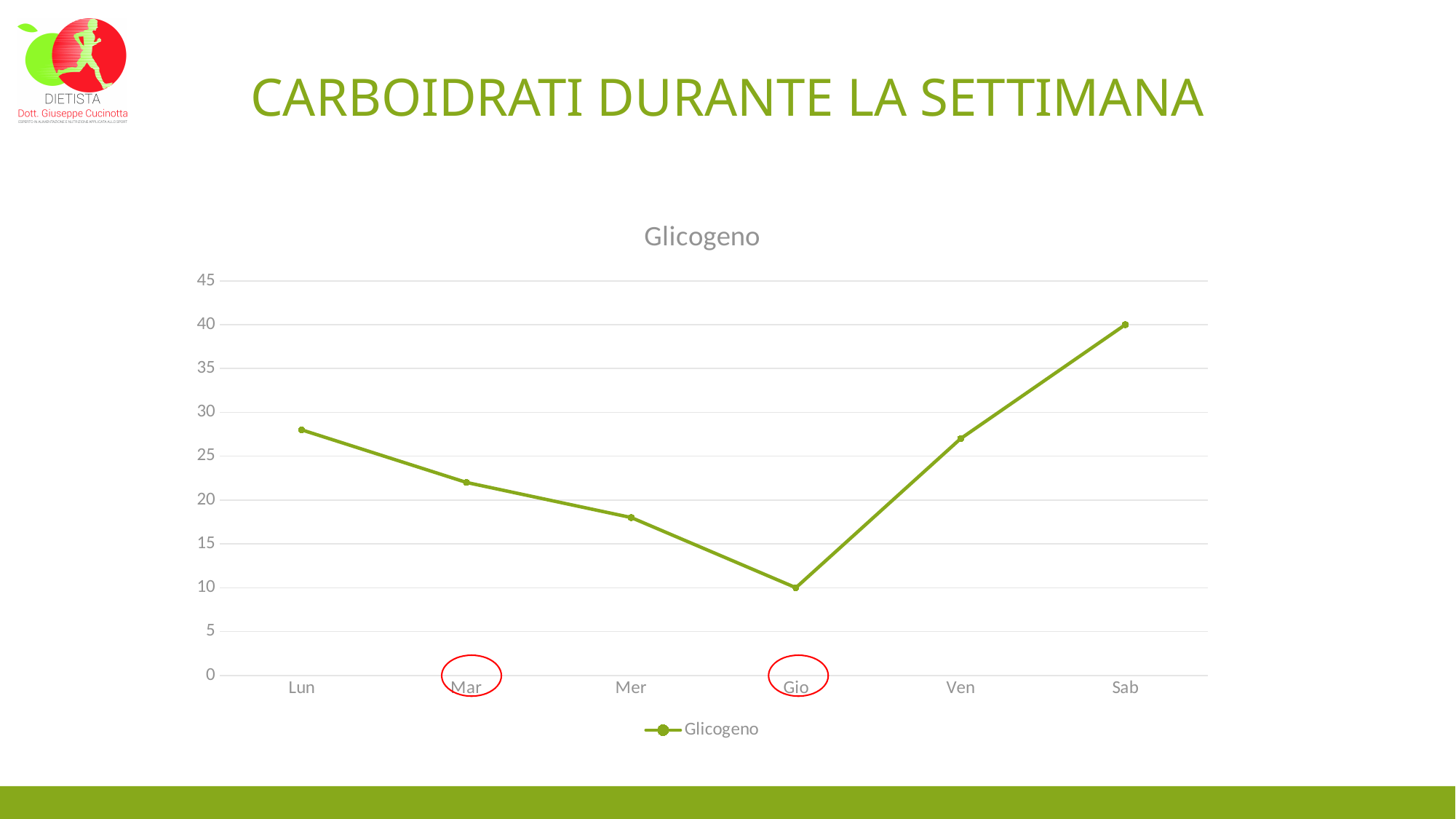
Does the line rise or fall from Lun to Gio? fall What is the title of the chart? Glicogeno Is the value for Mer greater or less than 20? less Which is larger, the value for Lun or the value for Mar? Lun What is the value for Gio? 10 How many days are plotted on the x axis? 6 Is the value for Lun greater or less than 25? greater What kind of chart is shown on the slide? line chart What is the value for Sab? 40 How many series does the legend list? 1 Which day has the lowest value? Gio Which day has the highest value? Sab